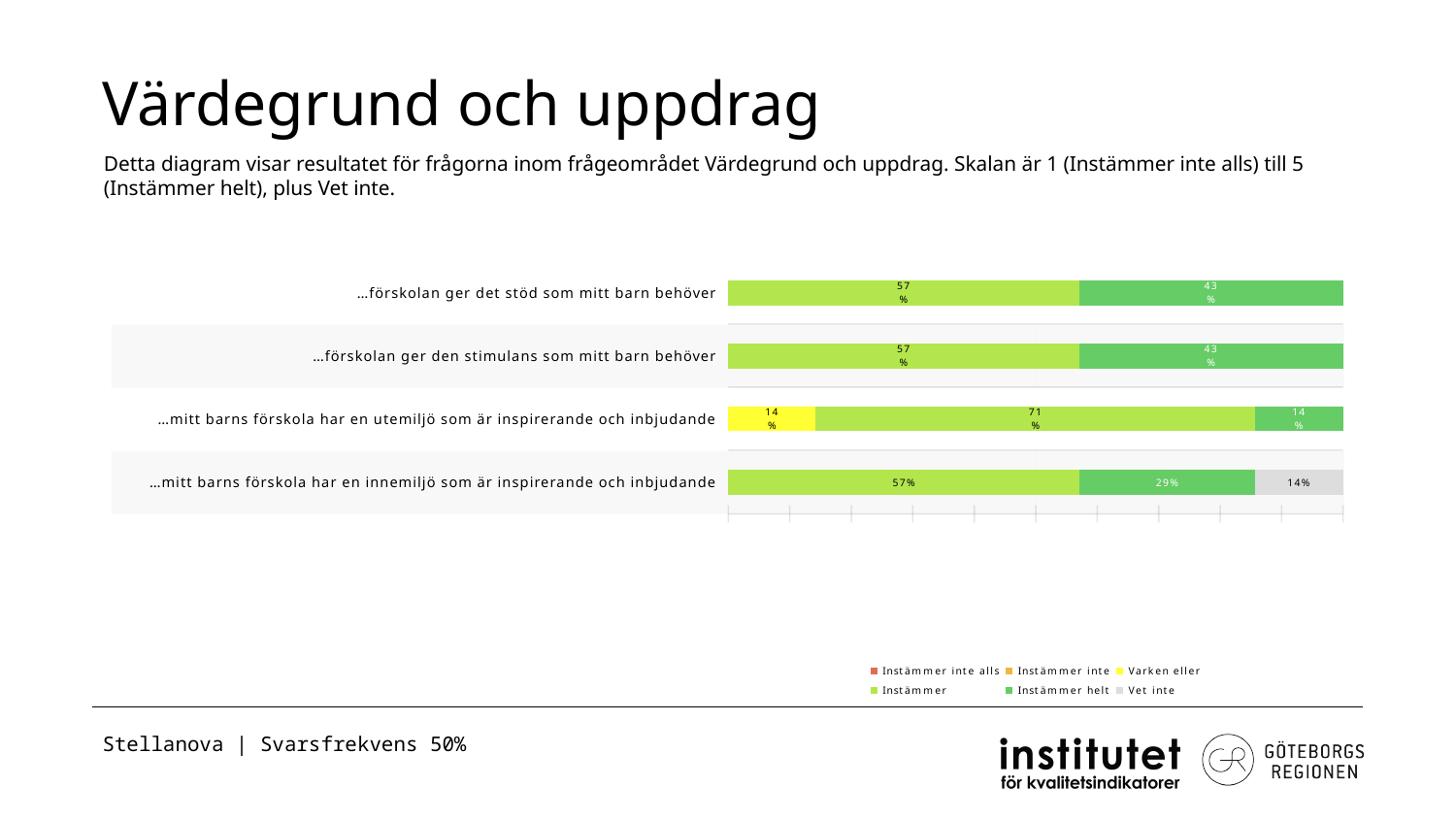
Which category has the highest 'Instämmer' value? …mitt barns förskola har en utemiljö som är inspirerande och inbjudande How many series does the legend list? 6 What is the 'Instämmer helt' value for '…förskolan ger den stimulans som mitt barn behöver'? 43% What is the difference between the 'Instämmer' and 'Instämmer helt' values for '…mitt barns förskola har en innemiljö som är inspirerande och inbjudande'? 28% What kind of chart is shown on the slide? stacked bar chart What is the 'Instämmer' value for '…mitt barns förskola har en utemiljö som är inspirerande och inbjudande'? 71% What is the 'Vet inte' value for '…mitt barns förskola har en innemiljö som är inspirerande och inbjudande'? 14% Which category has the lowest 'Instämmer helt' value? …mitt barns förskola har en utemiljö som är inspirerande och inbjudande How many categories (questions) are plotted in the chart? 4 Which is larger: the 'Instämmer helt' value for '…förskolan ger det stöd som mitt barn behöver' or for '…mitt barns förskola har en innemiljö som är inspirerande och inbjudande'? …förskolan ger det stöd som mitt barn behöver What is the 'Varken eller' value for '…mitt barns förskola har en utemiljö som är inspirerande och inbjudande'? 14% What is the 'Instämmer' value for '…förskolan ger det stöd som mitt barn behöver'? 57%